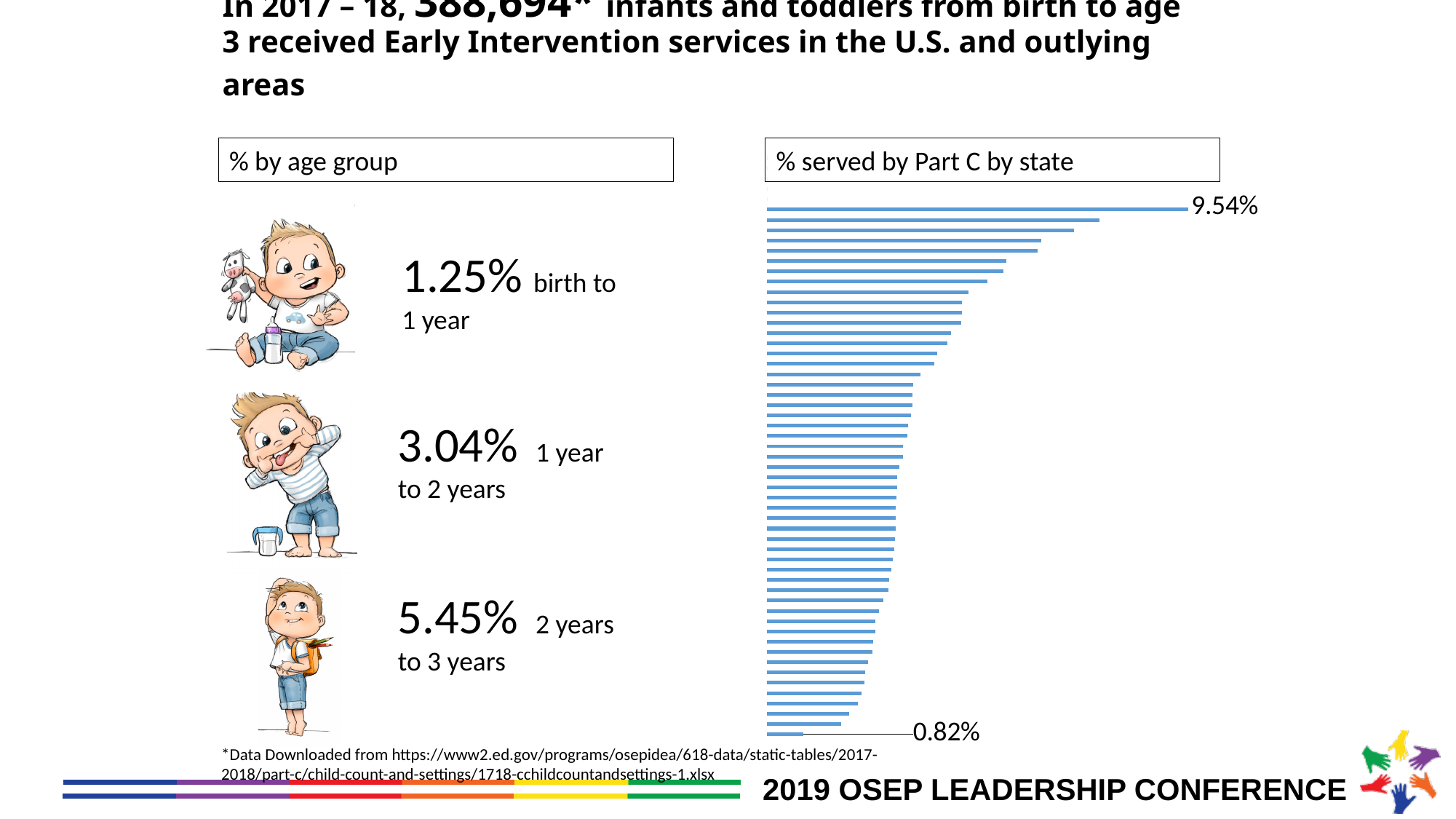
In the '% by age group' graphic, what percentage is shown for birth to 1 year? 1.25% In the '% by age group' graphic, what percentage is shown for 2 years to 3 years? 5.45% In the '% by age group' graphic, what is the difference between the 2 years to 3 years value and the birth to 1 year value? 4.2 percentage points In the '% by age group' graphic, which age group has the highest percentage? 2 years to 3 years In the '% by age group' graphic, what percentage is shown for 1 year to 2 years? 3.04% In the '% served by Part C by state' chart, what is the lowest value shown? 0.82% In the '% served by Part C by state' chart, what is the difference between the highest labelled value and the lowest labelled value? 8.72 percentage points In the '% served by Part C by state' chart, are the bars horizontal or vertical? horizontal In the '% served by Part C by state' chart, what is the highest value shown? 9.54% What kind of chart is the '% served by Part C by state' chart? bar chart What is the title of the bar chart on the right side of the slide? % served by Part C by state In the '% served by Part C by state' chart, do the bar lengths increase or decrease from the top of the chart to the bottom? decrease